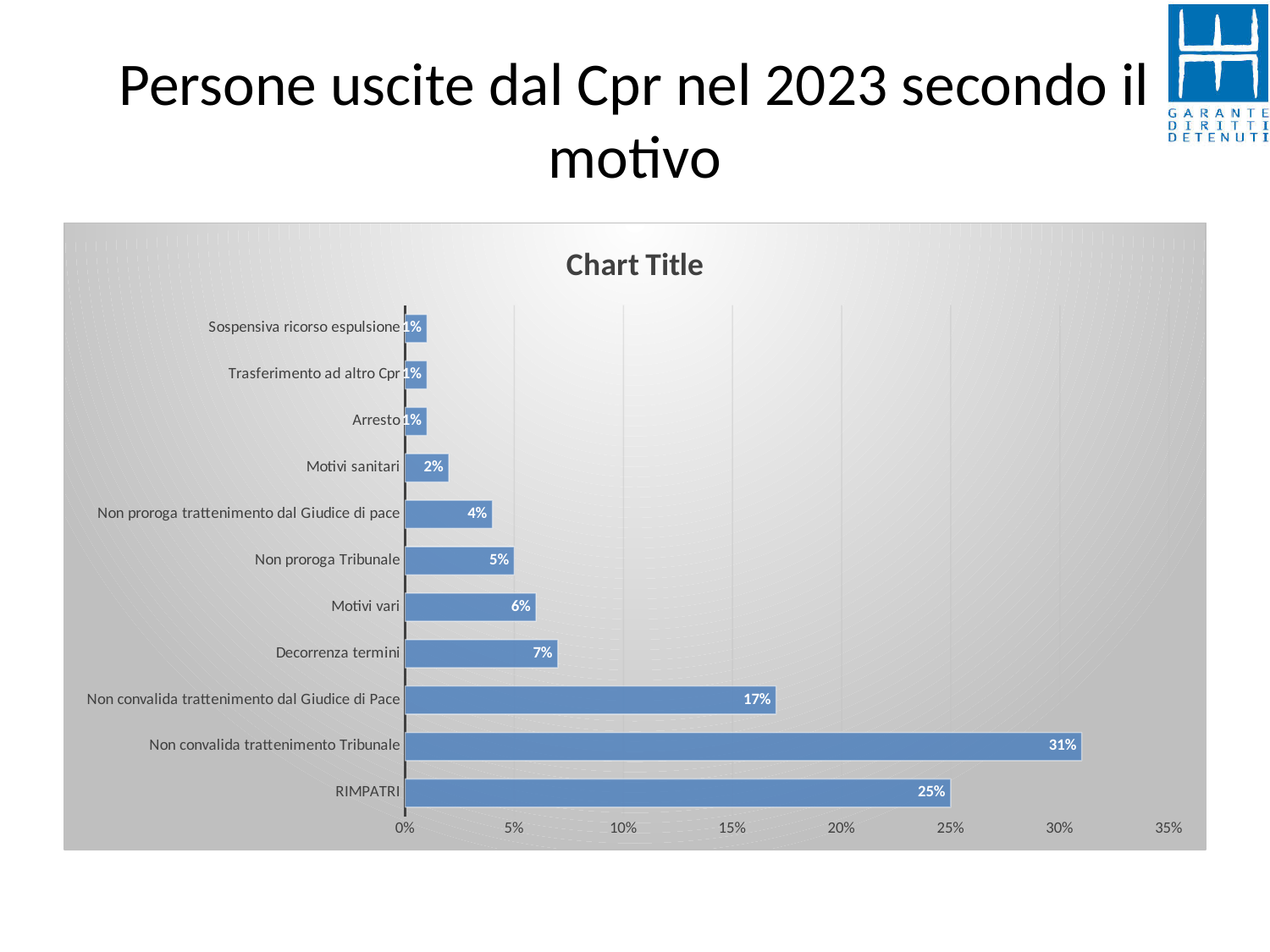
What is the value for Decorrenza termini? 7% Which category has the highest value? Non convalida trattenimento Tribunale What is the difference between Non convalida trattenimento Tribunale and RIMPATRI? 6% How many categories are shown in the chart? 11 What kind of chart is shown on the slide? Bar chart Which is larger, Motivi vari or Non proroga Tribunale? Motivi vari What is the title shown inside the chart area? Chart Title What is the value for Non convalida trattenimento dal Giudice di Pace? 17% What is the value for Motivi sanitari? 2% Is the value for Non convalida trattenimento Tribunale greater or less than 30%? greater What is the difference between Non convalida trattenimento dal Giudice di Pace and Decorrenza termini? 10% What is the value for RIMPATRI? 25%